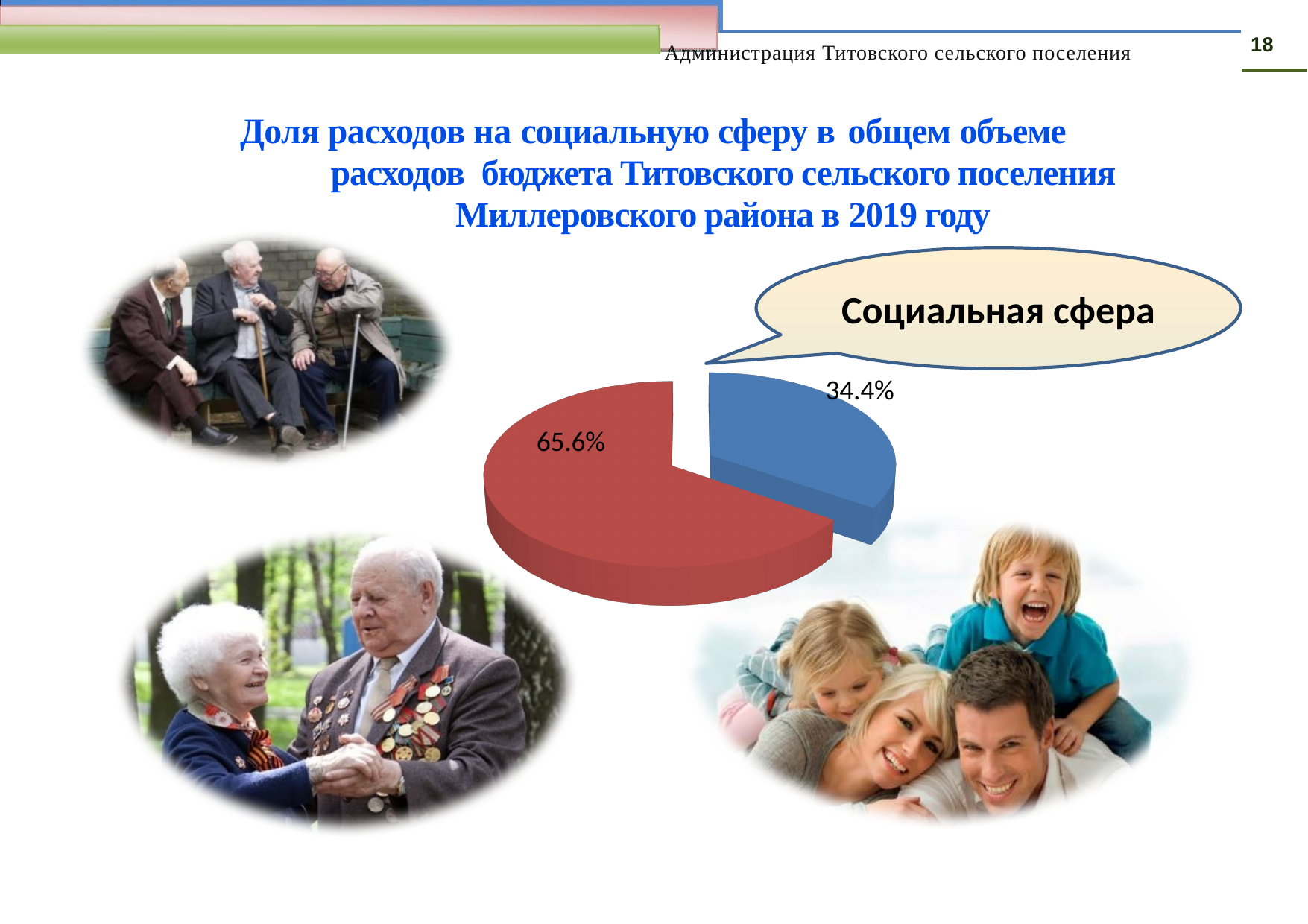
Which is larger: the share for Социальная сфера or the remaining share of expenditures? The remaining share (65.6%) What is the value shown on the blue slice of the pie chart? 34.4% Is the share for Социальная сфера greater or less than 50%? less What is the value shown on the red slice of the pie chart? 65.6% What colour is the slice labelled "Социальная сфера"? Blue What kind of chart is shown on the slide? Pie chart Which slice of the pie chart is the largest? The red slice (65.6%) Which slice of the pie chart is the smallest? The blue slice, Социальная сфера (34.4%) How many slices does the pie chart have? 2 Which year does the chart title say the data refers to? 2019 What share of the pie is labelled "Социальная сфера"? 34.4% What is the difference in percentage points between the two slices of the pie chart? 31.2